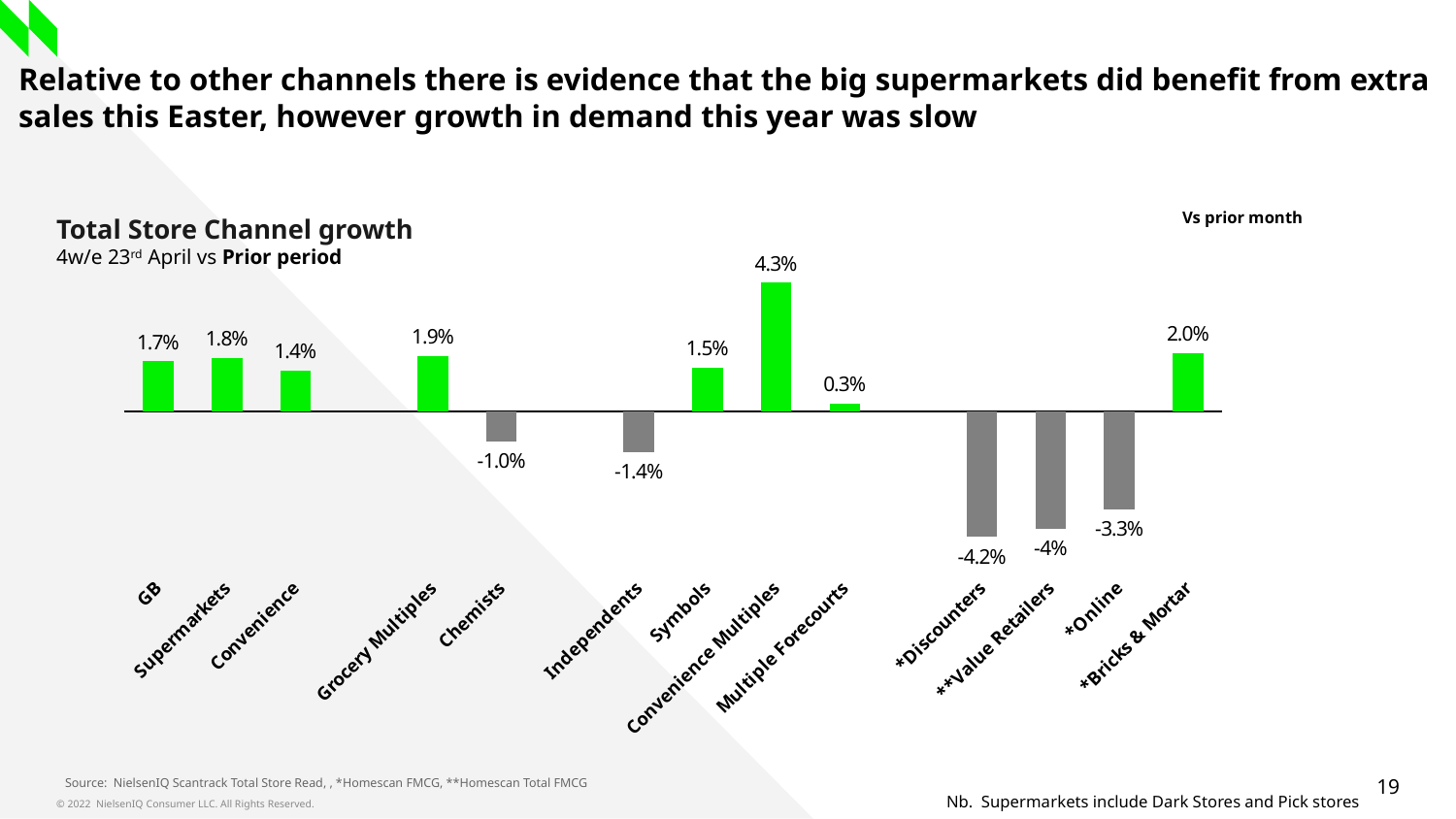
How many channels are shown in the Total Store Channel growth chart? 13 What is the difference between the values for Grocery Multiples and GB in the Total Store Channel growth chart? 0.2% What type of chart is the Total Store Channel growth chart? Bar chart What is the value for *Online in the Total Store Channel growth chart? -3.3% How many channels show negative growth in the Total Store Channel growth chart? 5 What is the value for Convenience Multiples in the Total Store Channel growth chart? 4.3% What period does the subtitle of the Total Store Channel growth chart state? 4w/e 23rd April vs Prior period What is the value for Supermarkets in the Total Store Channel growth chart? 1.8% Which has a higher value in the Total Store Channel growth chart, Symbols or Convenience? Symbols Which channel has the highest growth in the Total Store Channel growth chart? Convenience Multiples Which channel has the lowest growth in the Total Store Channel growth chart? *Discounters What is the value for Multiple Forecourts in the Total Store Channel growth chart? 0.3%